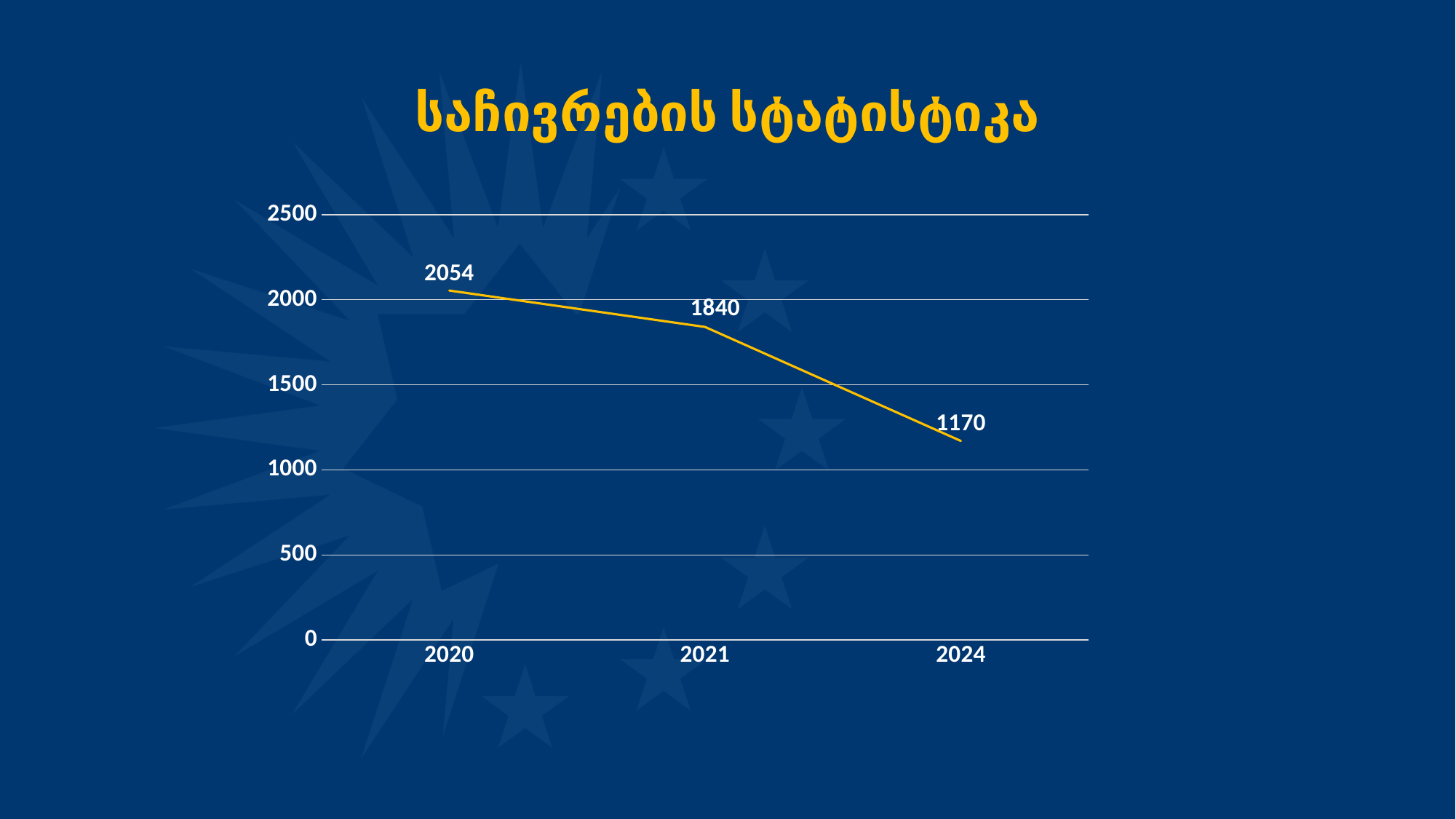
Do the values rise or fall from 2020 to 2024? fall What is the difference between the values for 2020 and 2021? 214 What is the difference between the values for 2020 and 2024? 884 Is the value for 2024 greater or less than 1500? less What is the value for 2020? 2054 Which is larger, the value for 2021 or the value for 2024? 2021 How many data points are plotted on the chart? 3 What kind of chart is shown on the slide? line chart What is the value for 2021? 1840 Which year has the highest value? 2020 Which year has the lowest value? 2024 What is the value for 2024? 1170